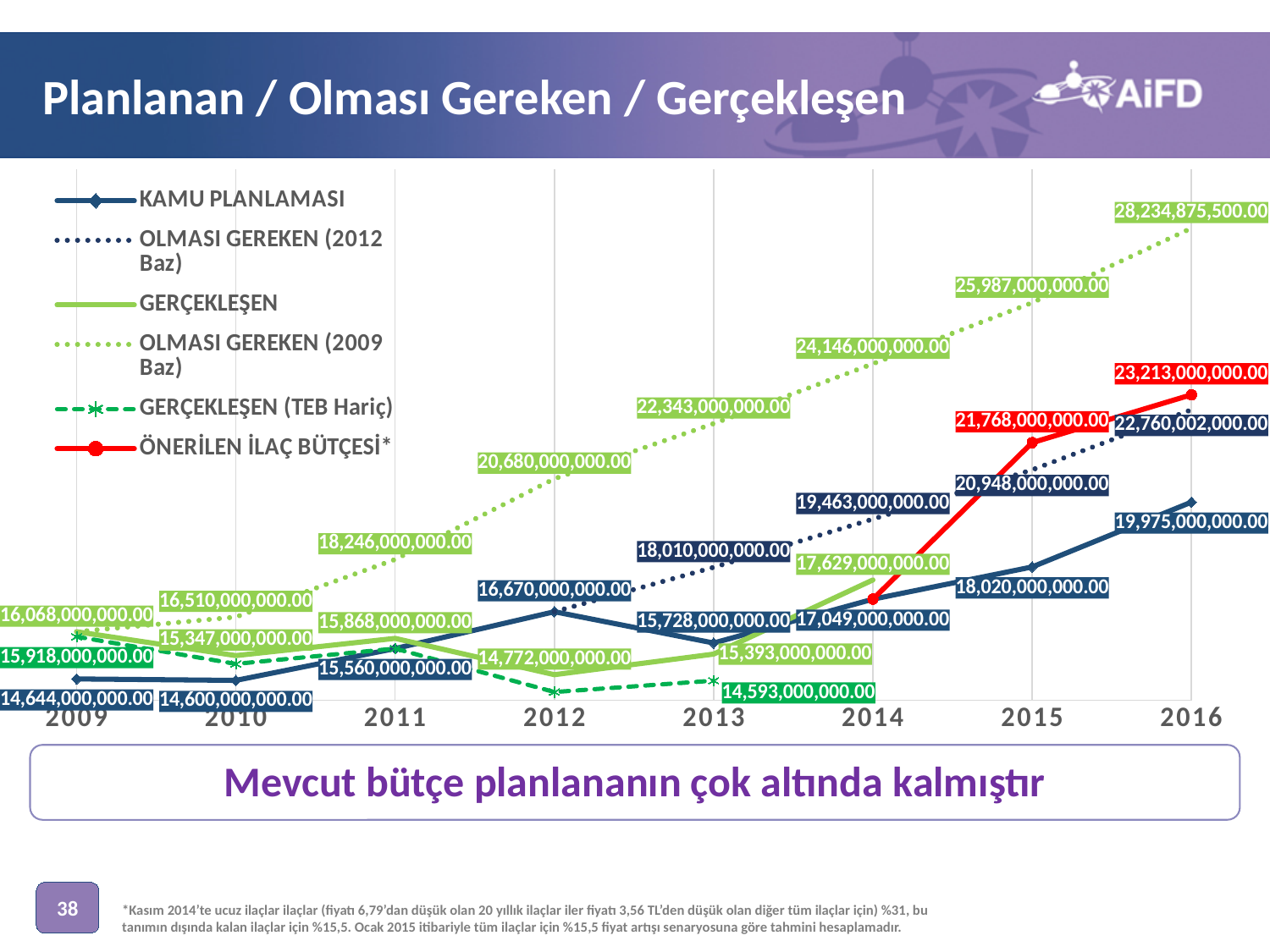
What is the value of OLMASI GEREKEN (2012 Baz) in 2014? 19,463,000,000.00 In which year is the OLMASI GEREKEN (2009 Baz) series at its highest? 2016 What is the value of KAMU PLANLAMASI in 2009? 14,644,000,000.00 What is the value of OLMASI GEREKEN (2009 Baz) in 2016? 28,234,875,500.00 How many years are shown on the x axis? 8 What is the difference between OLMASI GEREKEN (2009 Baz) and KAMU PLANLAMASI in 2016? 8,259,875,500.00 Does the OLMASI GEREKEN (2009 Baz) series rise or fall from 2009 to 2016? rise Which is larger in 2016: ÖNERİLEN İLAÇ BÜTÇESİ* or OLMASI GEREKEN (2012 Baz)? ÖNERİLEN İLAÇ BÜTÇESİ* What kind of chart is shown on the slide? line chart What is the value of ÖNERİLEN İLAÇ BÜTÇESİ* in 2015? 21,768,000,000.00 In which year is the KAMU PLANLAMASI series at its lowest? 2010 How many series does the legend list? 6